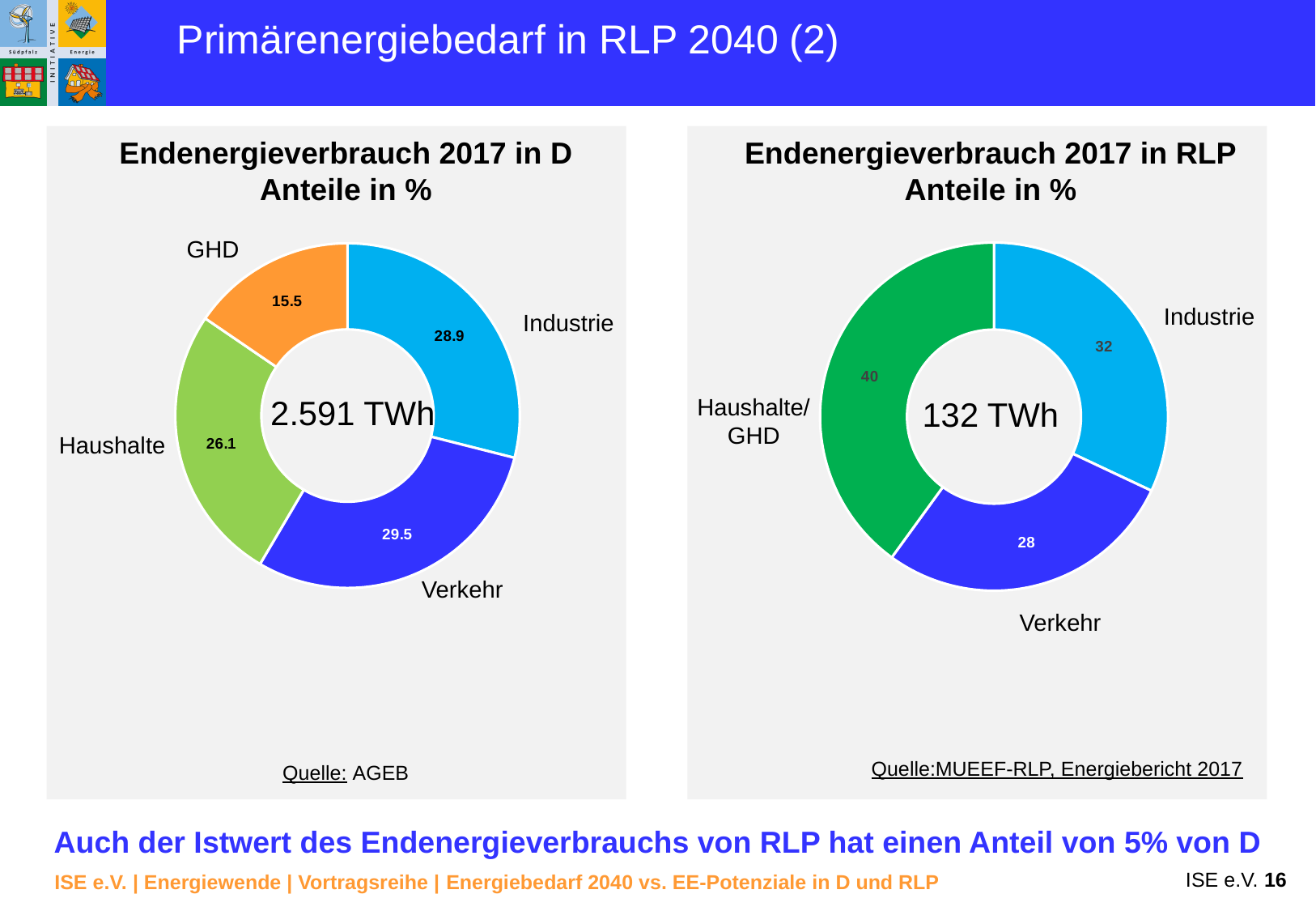
What kind of chart is the 'Endenergieverbrauch 2017 in RLP' chart? Doughnut chart In the 'Endenergieverbrauch 2017 in RLP' chart, what is the share for Verkehr? 28 In the 'Endenergieverbrauch 2017 in D' chart, which sector has the largest share? Verkehr In the 'Endenergieverbrauch 2017 in RLP' chart, which sector has the largest share? Haushalte/GHD In the 'Endenergieverbrauch 2017 in RLP' chart, what is the difference between the Industrie share and the Verkehr share? 4 In the 'Endenergieverbrauch 2017 in D' chart, what is the share for Industrie? 28.9 In the 'Endenergieverbrauch 2017 in RLP' chart, how many sectors are shown? 3 In the 'Endenergieverbrauch 2017 in D' chart, what is the share for GHD? 15.5 In the 'Endenergieverbrauch 2017 in D' chart, which sector has the smallest share? GHD In the 'Endenergieverbrauch 2017 in D' chart, how many sectors are shown? 4 What total value is shown in the centre of the 'Endenergieverbrauch 2017 in D' chart? 2.591 TWh In the 'Endenergieverbrauch 2017 in D' chart, what is the difference between the Haushalte share and the GHD share? 10.6